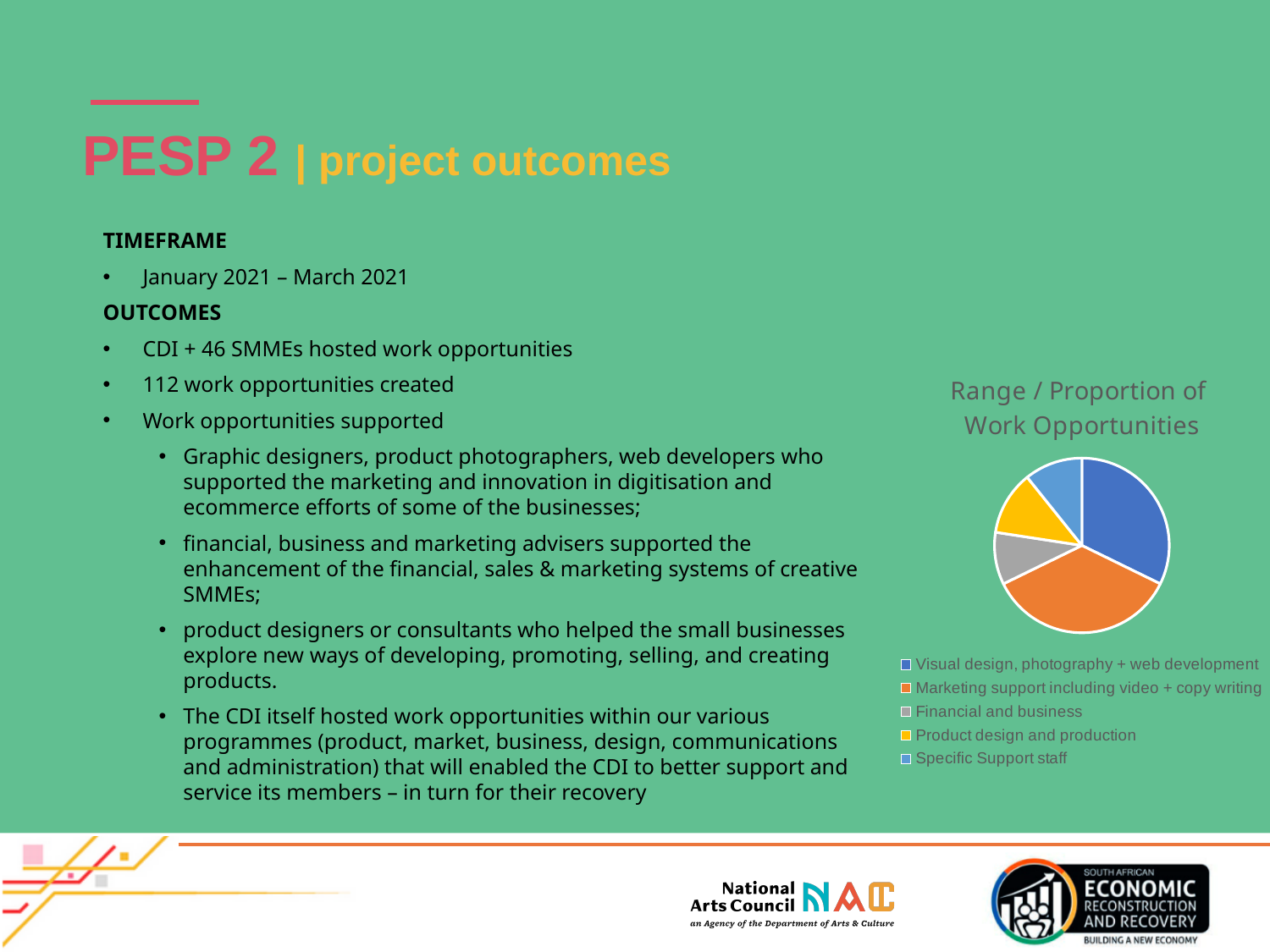
Which slice is larger: Visual design, photography + web development or Specific Support staff? Visual design, photography + web development Which category has the smallest slice in the pie chart? Financial and business How many slices does the pie chart have? 5 Which slice is larger: Marketing support including video + copy writing or Financial and business? Marketing support including video + copy writing How many entries does the chart's legend list? 5 Which colour represents Product design and production in the pie chart? yellow Which slice is larger: Visual design, photography + web development or Financial and business? Visual design, photography + web development What is the title of the chart on the slide? Range / Proportion of Work Opportunities What kind of chart is shown on the slide? pie chart